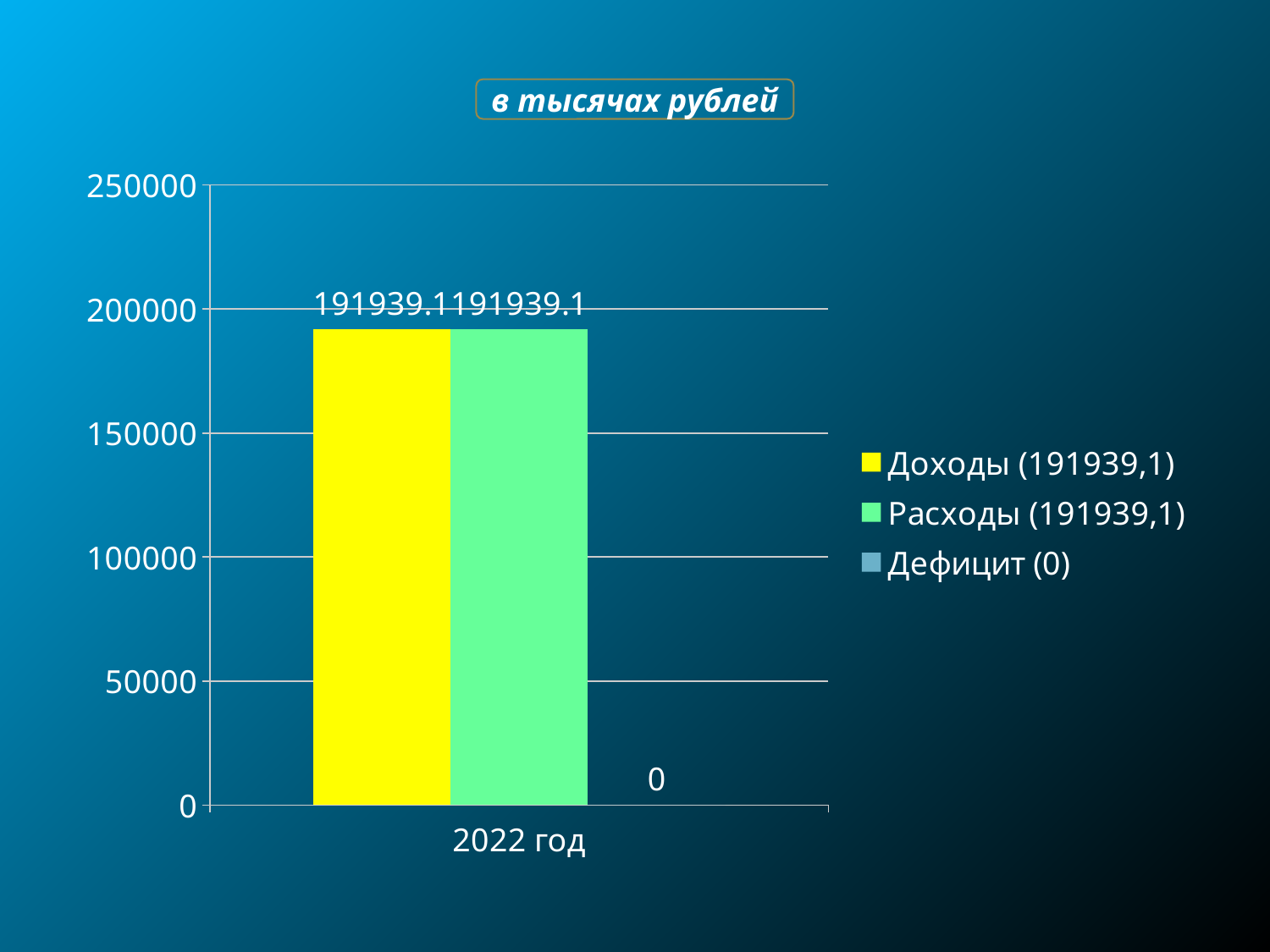
What is the value of Доходы for 2022 год? 191939.1 What is the difference between Доходы and Расходы for 2022 год? 0 What unit label is shown above the chart? в тысячах рублей Is the value for Расходы greater or less than 200000? less How many series does the legend list? 3 Is the value for Доходы greater or less than 150000? greater What is the value of Дефицит for 2022 год? 0 Which is larger for 2022 год, Доходы or Дефицит? Доходы Which series has the lowest value for 2022 год? Дефицит How many categories are shown on the x axis? 1 What kind of chart is shown on the slide? bar chart What is the value of Расходы for 2022 год? 191939.1